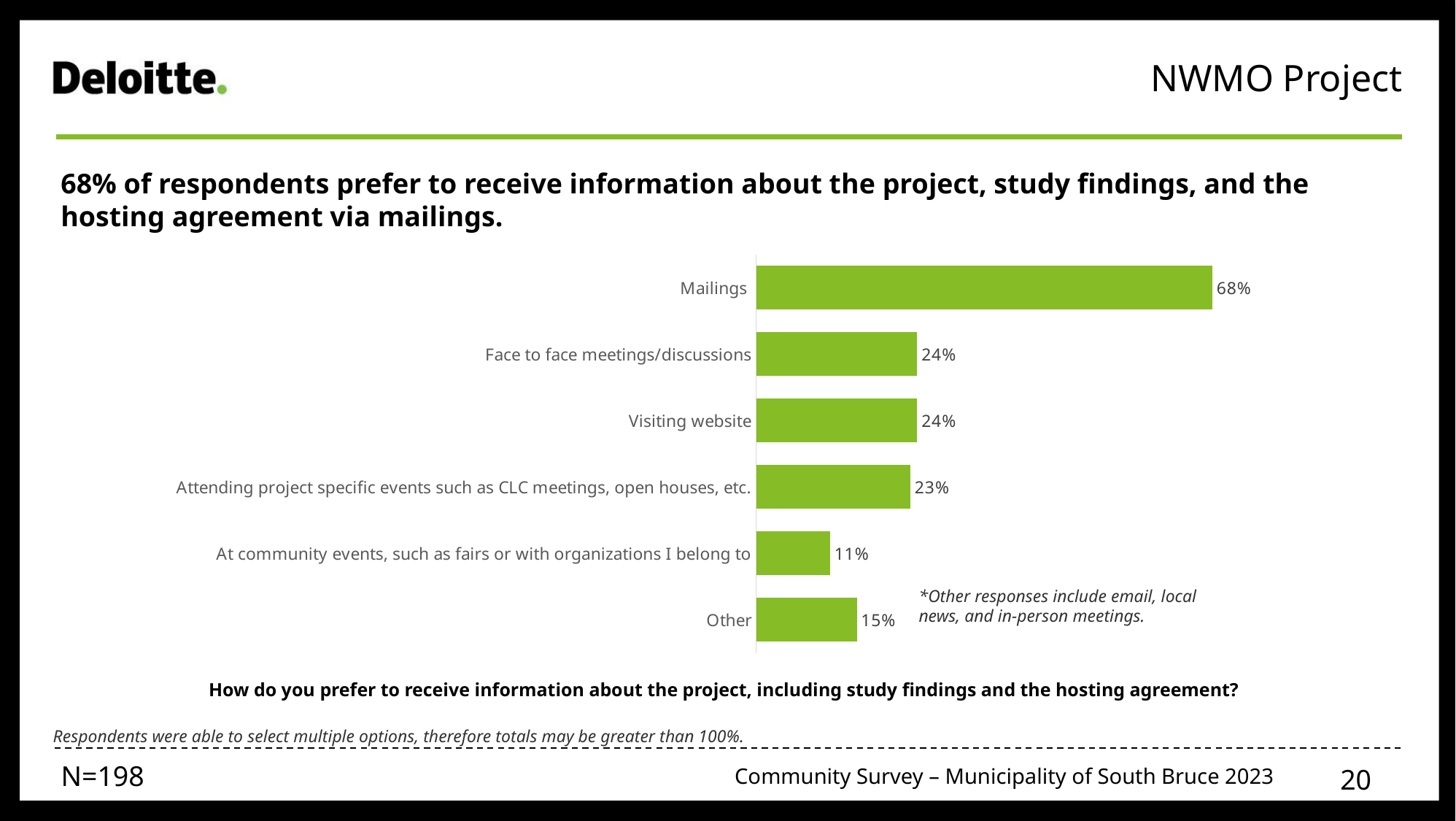
What percentage of respondents prefer to receive information via Mailings? 68% Which category has the lowest value? At community events, such as fairs or with organizations I belong to What is the value for Visiting website? 24% What is the difference between the value for Mailings and the value for Face to face meetings/discussions? 44% What kind of chart is shown on the slide? Bar chart What is the value for Other? 15% How many categories are shown in the chart? 6 Which category has the highest value? Mailings Which is larger: the value for Other or the value for 'At community events, such as fairs or with organizations I belong to'? Other What is the value for 'Attending project specific events such as CLC meetings, open houses, etc.'? 23% What percentage of respondents chose 'At community events, such as fairs or with organizations I belong to'? 11% What colour are the bars in the chart? Green